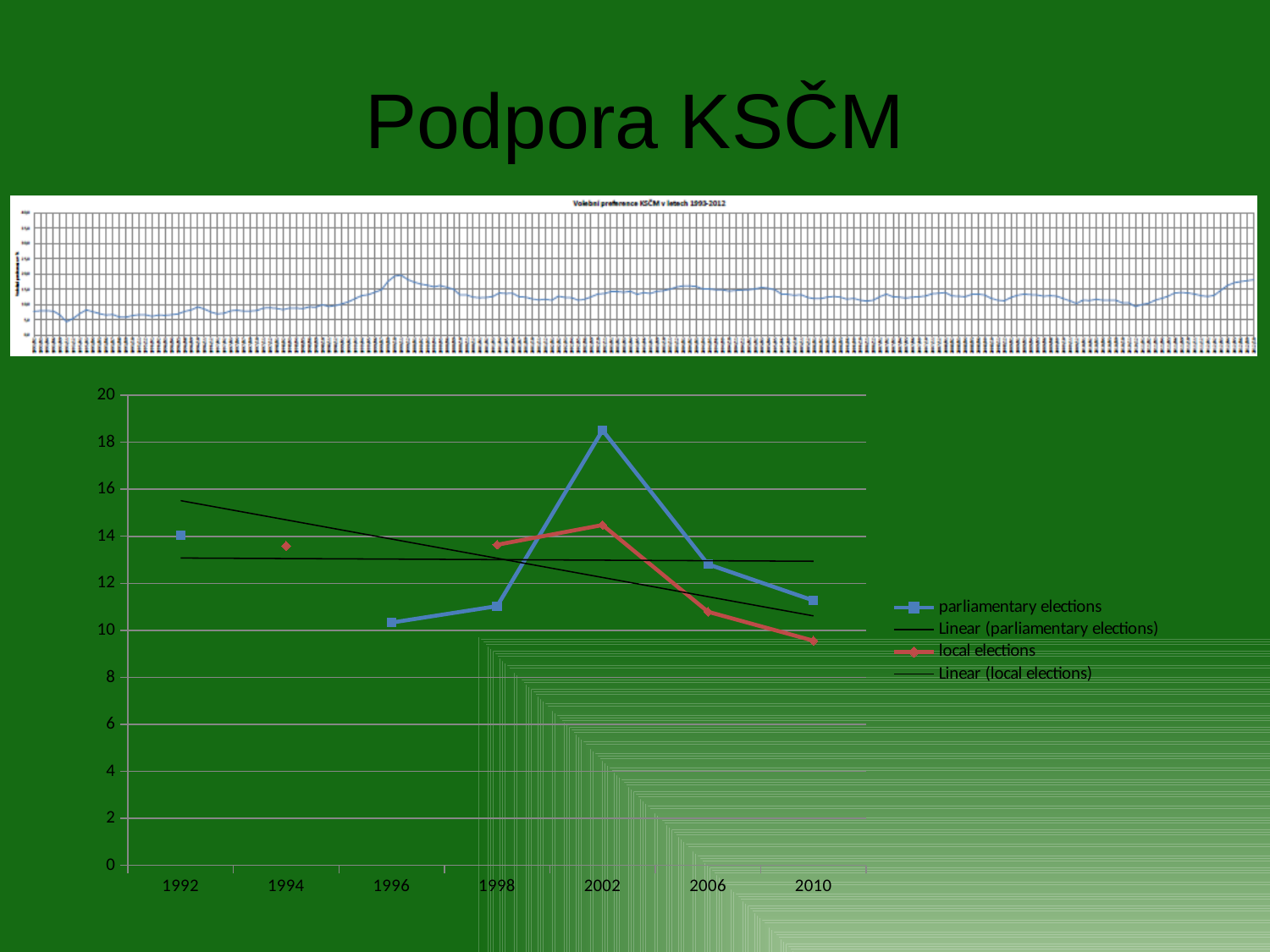
In the bottom chart, how many entries does the legend list? 4 In the bottom chart, is the parliamentary elections value for 2002 greater or less than 16? greater In the bottom chart, in which year is the parliamentary elections value lowest? 1996 In the bottom chart, in which year is the parliamentary elections value highest? 2002 In the bottom chart, what kind of chart is used to show the election results? line chart In the bottom chart, in which year is the local elections value lowest? 2010 In the bottom chart, do the local elections values rise or fall from 2002 to 2010? fall In the bottom chart, how many years are labelled on the x axis? 7 In the bottom chart, in which year is the local elections value highest? 2002 In the bottom chart, which series has the larger value in 1998, parliamentary elections or local elections? local elections In the bottom chart, is the local elections value for 2010 greater or less than 12? less In the bottom chart, is the parliamentary elections value for 1992 greater or less than 12? greater